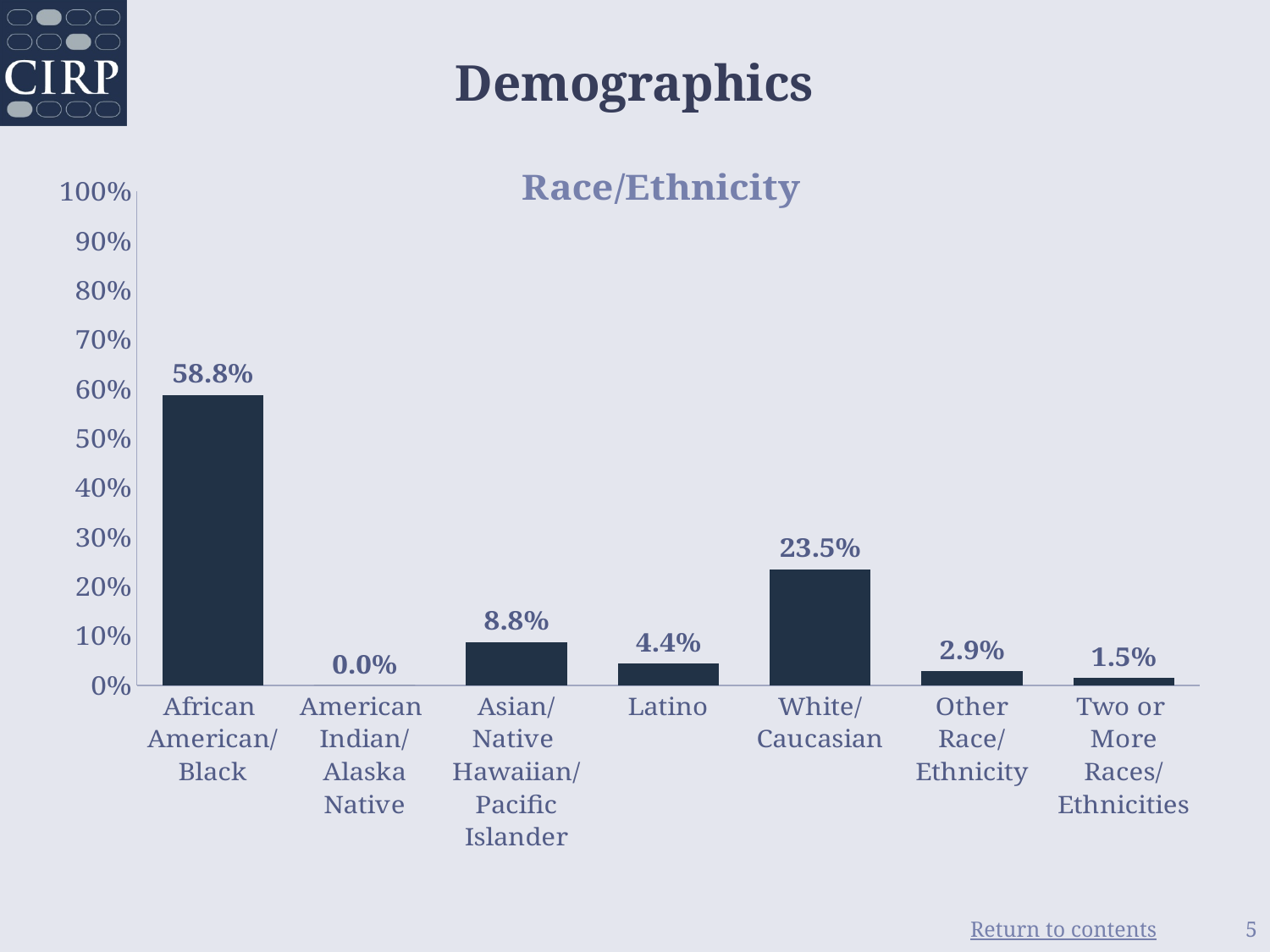
What is the value for African American/Black? 58.8% Which category has the lowest value? American Indian/Alaska Native What is the title of the chart? Race/Ethnicity What is the value for Two or More Races/Ethnicities? 1.5% What is the value for White/Caucasian? 23.5% What kind of chart is shown? bar chart Which is larger, the value for Latino or the value for Other Race/Ethnicity? Latino What is the value for Asian/Native Hawaiian/Pacific Islander? 8.8% How many categories are shown on the x axis? 7 Which category has the highest value? African American/Black What is the difference between the values for African American/Black and White/Caucasian? 35.3% Is the value for White/Caucasian greater or less than 30%? less